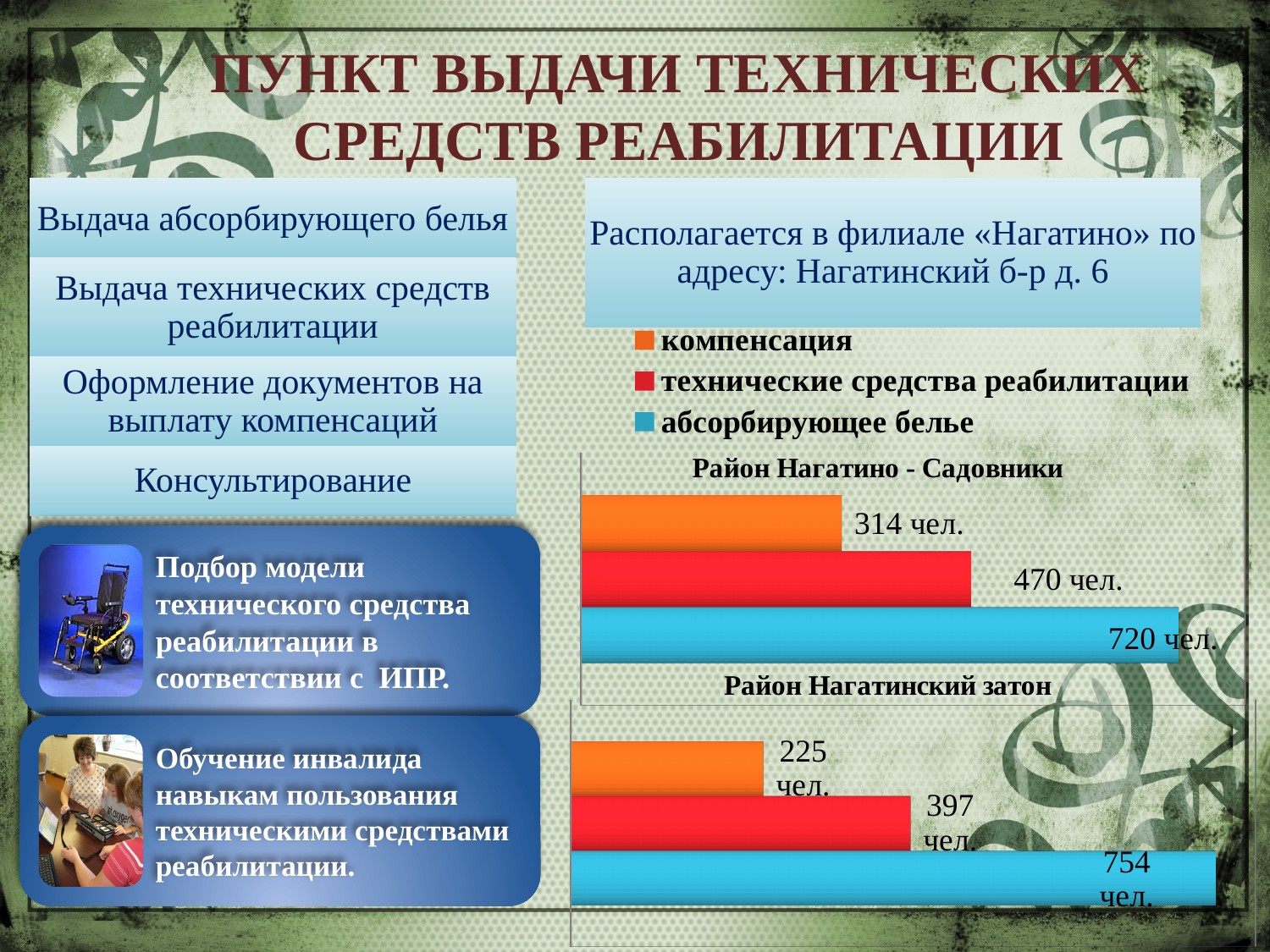
In the chart titled "Район Нагатинский затон", what is the value for "технические средства реабилитации"? 397 чел. In the chart titled "Район Нагатино - Садовники", which category has the highest value? абсорбирующее белье In the chart titled "Район Нагатино - Садовники", what is the difference between "абсорбирующее белье" and "компенсация"? 406 чел. How many series does the legend list for the charts on the slide? 3 In the chart titled "Район Нагатинский затон", which category has the lowest value? компенсация In the chart titled "Район Нагатинский затон", what is the value for "абсорбирующее белье"? 754 чел. Which is larger: "технические средства реабилитации" in the chart "Район Нагатино - Садовники" or in the chart "Район Нагатинский затон"? Район Нагатино - Садовники In the chart titled "Район Нагатино - Садовники", what is the value for "технические средства реабилитации"? 470 чел. What kind of chart is "Район Нагатинский затон"? bar chart In the chart titled "Район Нагатинский затон", what is the value for "компенсация"? 225 чел. In the chart titled "Район Нагатино - Садовники", what is the value for "компенсация"? 314 чел. In the chart titled "Район Нагатино - Садовники", what is the value for "абсорбирующее белье"? 720 чел.